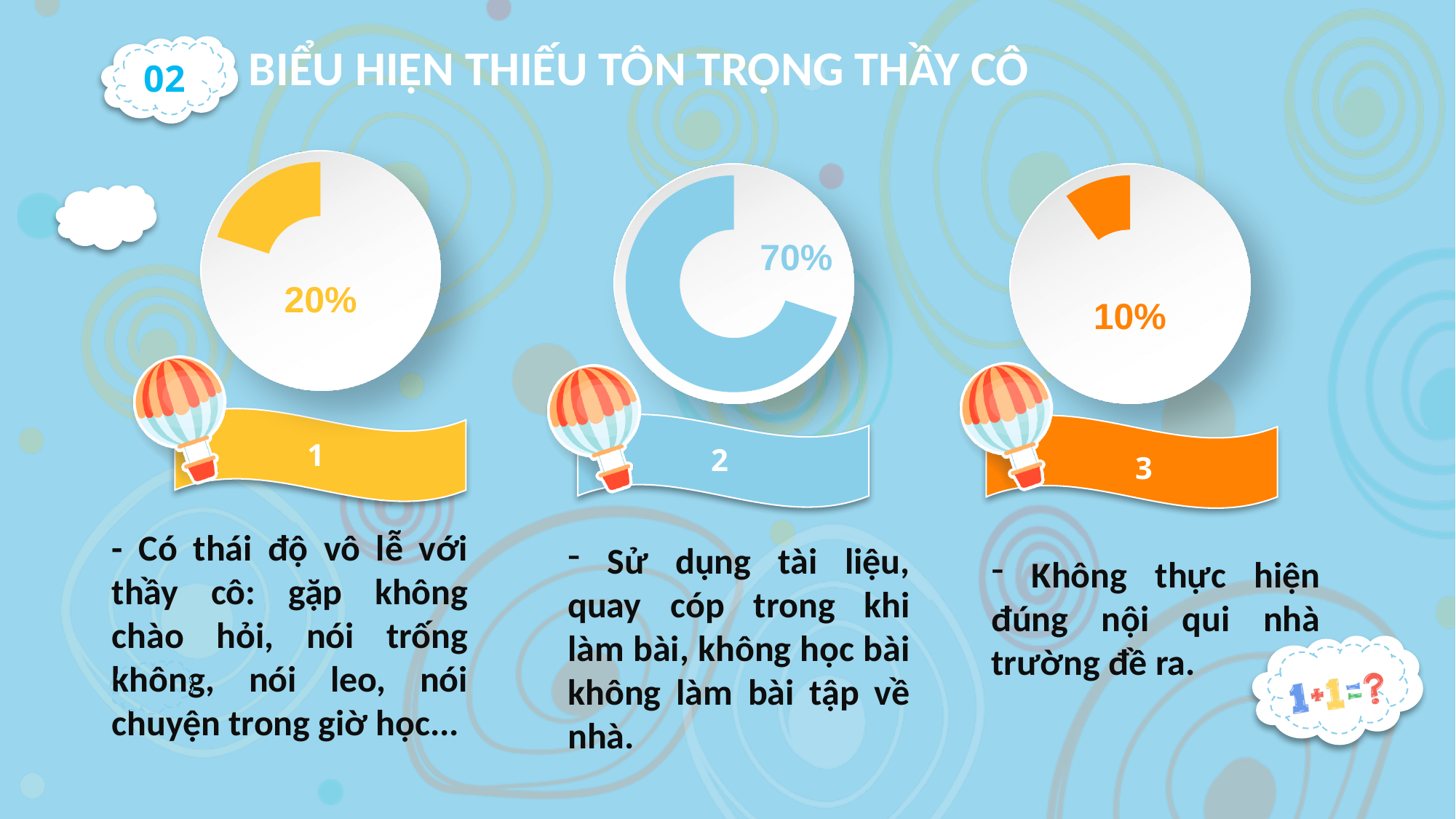
Which of the three charts shows the lowest percentage? The right chart (3), 10% What is the difference between the percentage in the left chart (1) and the right chart (3)? 10 percentage points Which is larger, the percentage in the left chart (1) or the right chart (3)? The left chart (1), 20% What colour is the filled segment of the middle chart (2)? Blue What do the three percentages shown in the charts add up to? 100% What is the difference between the percentage in the middle chart (2) and the left chart (1)? 50 percentage points What percentage is shown in the left chart (labelled 1)? 20% Which of the three charts shows the highest percentage? The middle chart (2), 70% What percentage is shown in the right chart (labelled 3)? 10% What percentage is shown in the middle chart (labelled 2)? 70% How many charts are shown on the slide? 3 What kind of chart is used for each of the three percentages on the slide? Donut (pie) chart